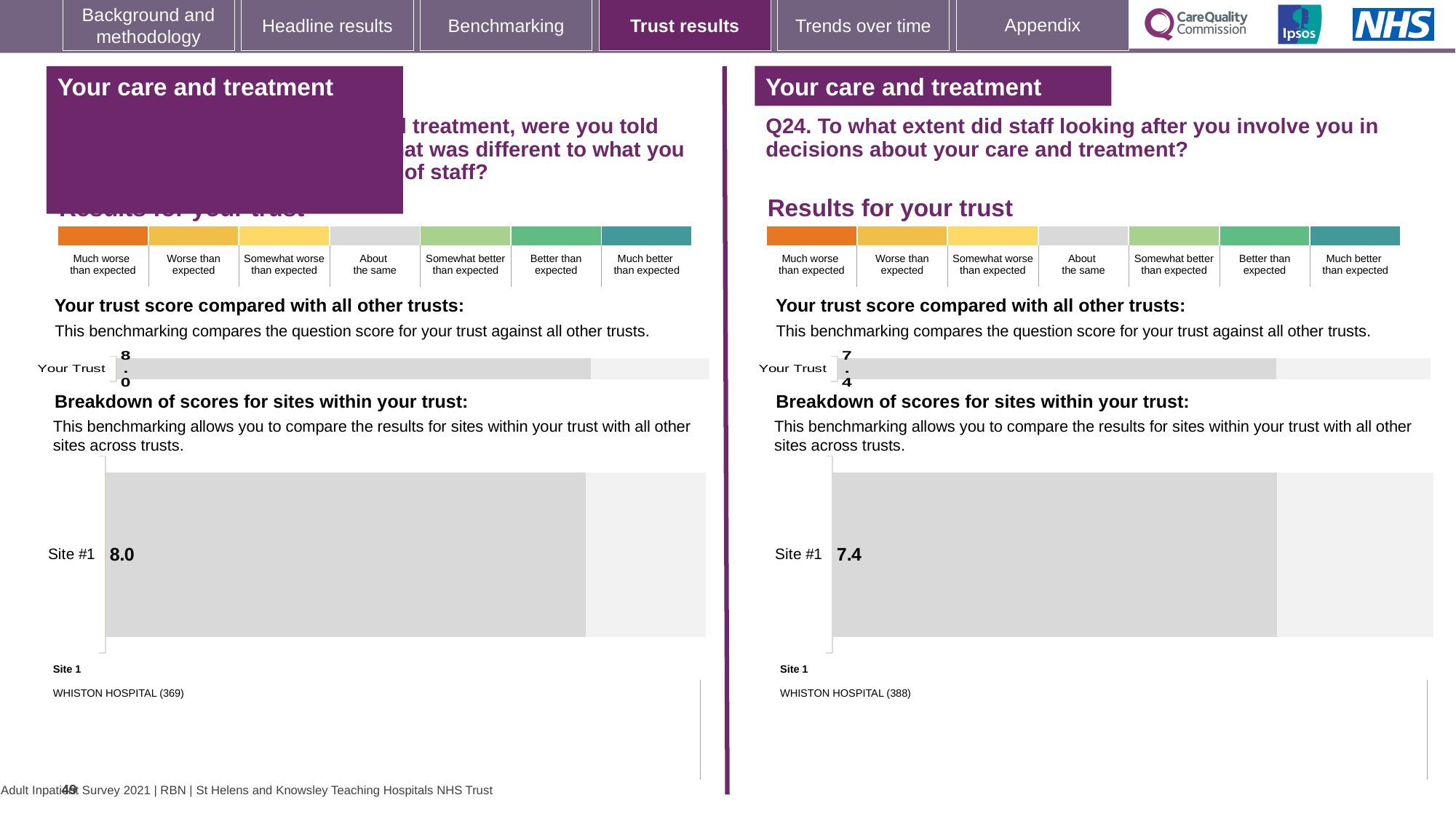
Which panel shows the higher Site #1 score, the left-hand panel or the right-hand panel (Q24)? the left-hand panel On the right-hand panel (Q24), which hospital is listed as Site 1? WHISTON HOSPITAL (388) On the right-hand panel (Q24), is the Your Trust score greater or less than the Site #1 score, or are they equal? equal What is the difference between the Site #1 score on the left-hand panel and the Site #1 score on the right-hand panel (Q24)? 0.6 How many sites are shown in the breakdown of scores on the right-hand panel (Q24)? 1 On the right-hand panel (Q24), what is the score shown for Your Trust? 7.4 On the left-hand panel, which hospital is listed as Site 1? WHISTON HOSPITAL (369) On the left-hand panel, what is the score shown for Your Trust? 8.0 On the right-hand panel (Q24), what is the score shown for Site #1? 7.4 What kind of chart is used to show the Site #1 score on the right-hand panel (Q24)? bar chart On the left-hand panel, what is the score shown for Site #1? 8.0